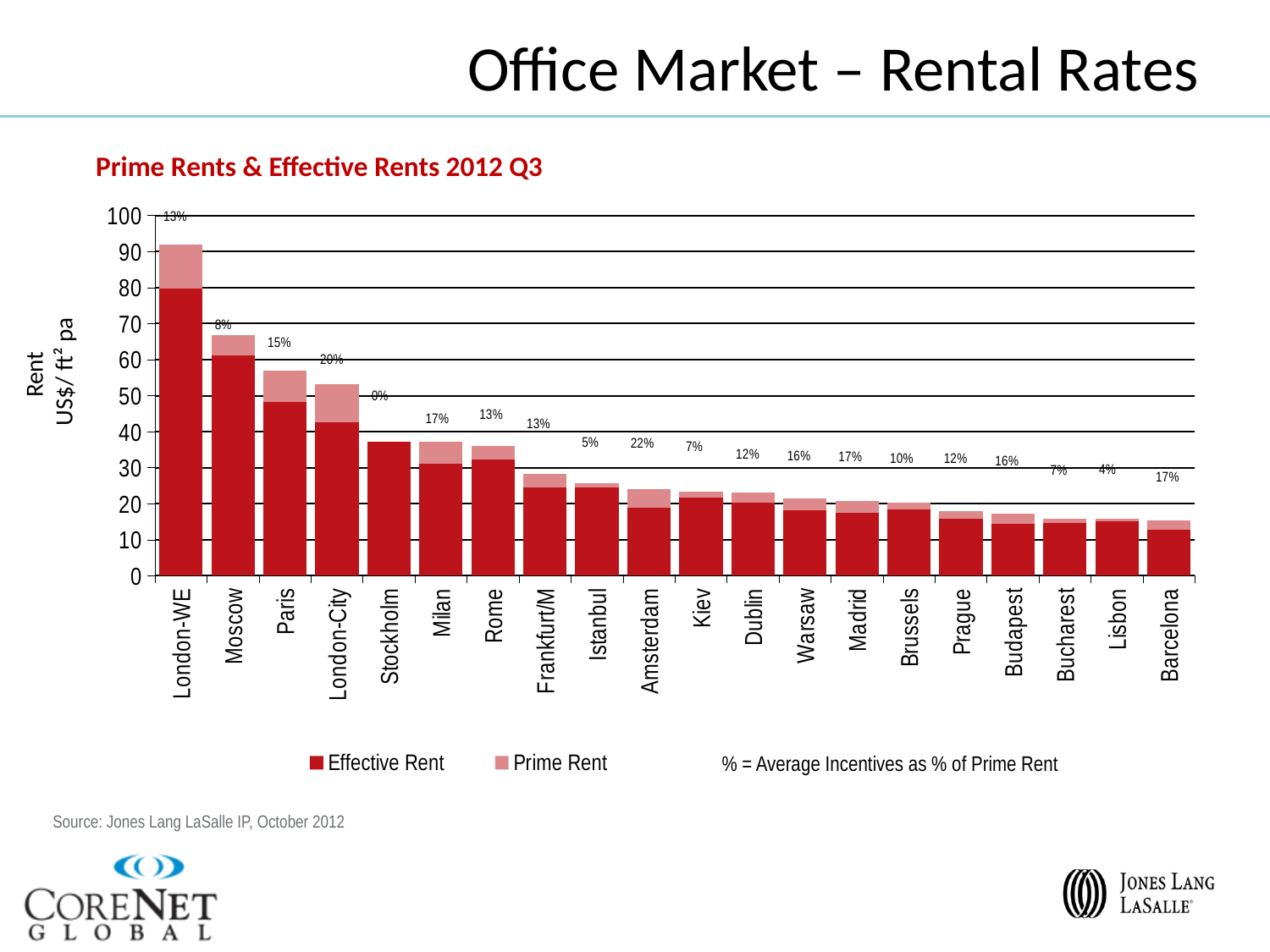
How many cities are shown on the x axis of the chart? 20 How many series does the chart legend list? 2 Which city has the highest average incentive percentage label? Amsterdam What is the average incentive percentage shown for Stockholm? 0% What is the average incentive percentage shown for Amsterdam? 22% Which city has the highest rent bar in the chart? London-WE Is the total bar height for London-WE greater or less than 80? greater Which city has the lowest rent bar in the chart? Barcelona What kind of chart is shown on the slide? Bar chart Do the rent values generally rise or fall from left to right along the x axis? fall What is the average incentive percentage shown for London-City? 20% Is the total bar height for Stockholm greater or less than 40? less